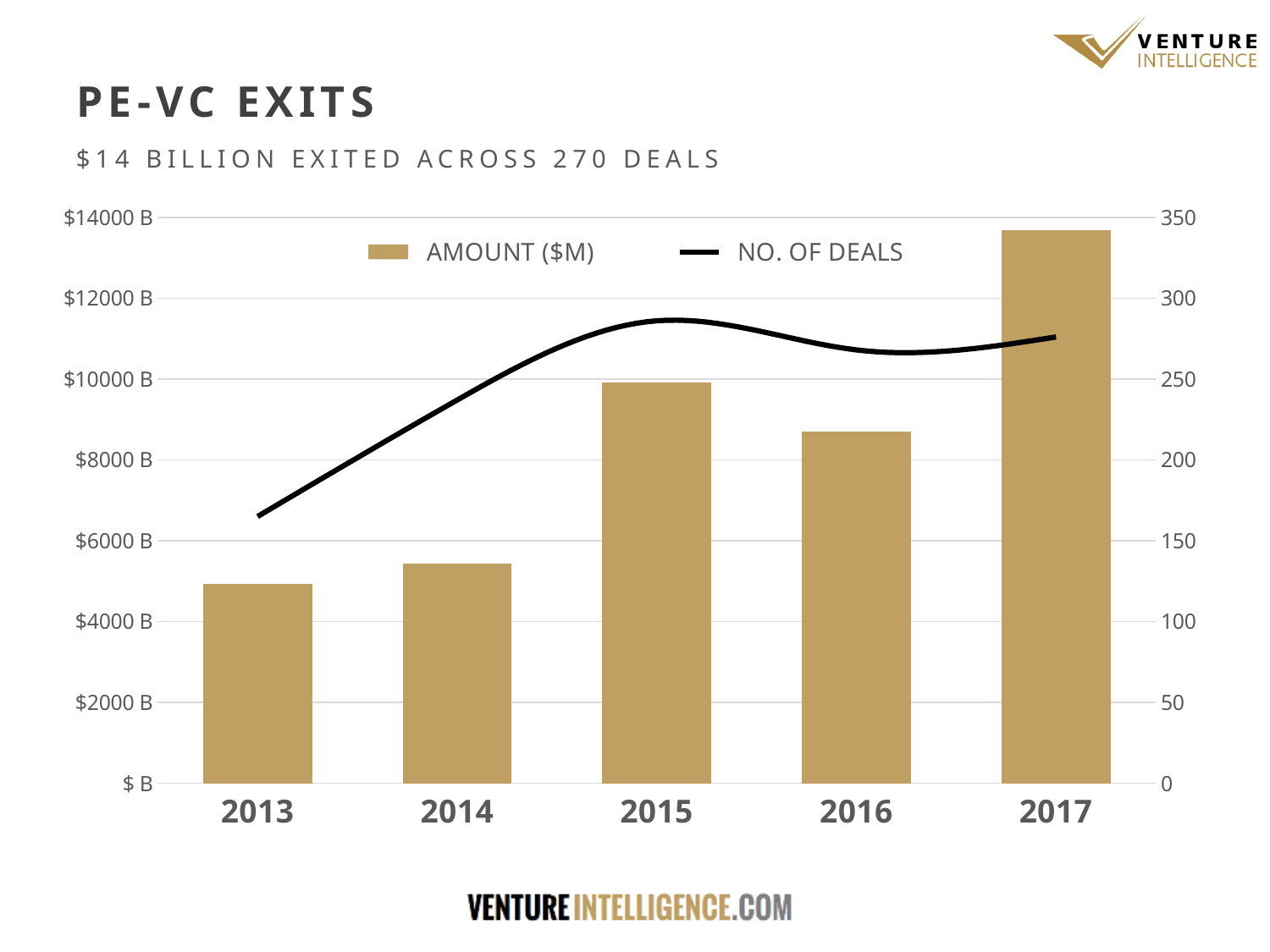
Which year has a larger AMOUNT ($M) bar, 2015 or 2016? 2015 Does the AMOUNT ($M) bar rise or fall from 2013 to 2017 overall? Rise How many years are shown on the x axis of the chart? 5 How many series does the chart legend list? 2 Is the NO. OF DEALS value for 2013 greater or less than 200 on the right axis? less What kind of chart is shown on the slide? A combined bar and line chart In which year does the NO. OF DEALS line reach its peak? 2015 Which year has the lowest AMOUNT ($M) bar? 2013 What is the title of the chart on the slide? PE-VC EXITS Which year has the highest AMOUNT ($M) bar? 2017 Is the AMOUNT ($M) bar for 2013 greater or less than $6000 B on the left axis? less Is the AMOUNT ($M) bar for 2017 greater or less than $12000 B on the left axis? greater